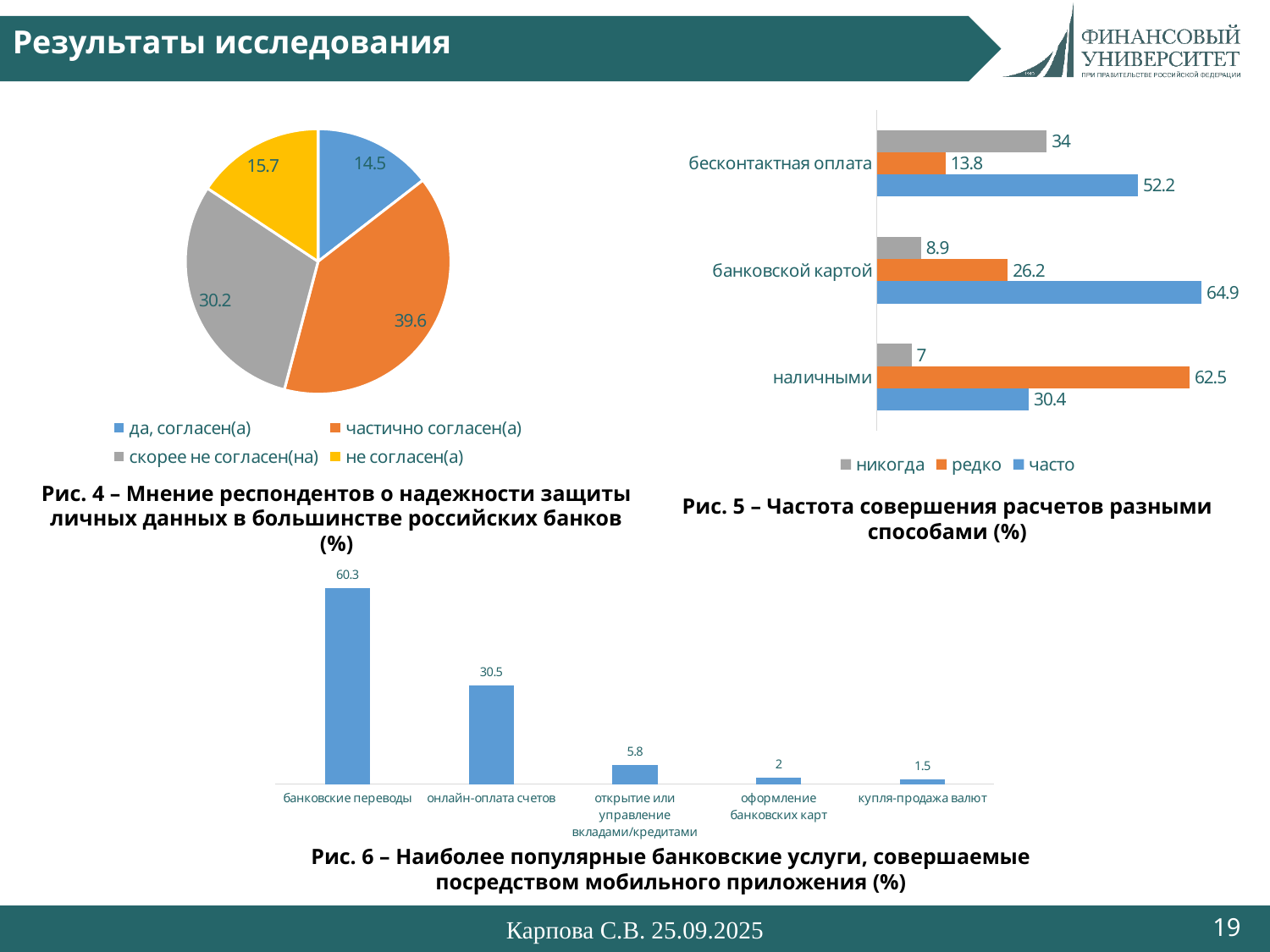
In the chart 'Рис. 6 – Наиболее популярные банковские услуги, совершаемые посредством мобильного приложения (%)', which category has the highest value? банковские переводы In the chart 'Рис. 4 – Мнение респондентов о надежности защиты личных данных в большинстве российских банков (%)', what is the value for 'частично согласен(а)'? 39.6 In the chart 'Рис. 4 – Мнение респондентов о надежности защиты личных данных в большинстве российских банков (%)', how many categories does the legend list? 4 In the chart 'Рис. 5 – Частота совершения расчетов разными способами (%)', what is the value of 'никогда' for 'наличными'? 7 In the chart 'Рис. 6 – Наиболее популярные банковские услуги, совершаемые посредством мобильного приложения (%)', what is the value for 'онлайн-оплата счетов'? 30.5 In the chart 'Рис. 5 – Частота совершения расчетов разными способами (%)', what is the value of 'часто' for 'банковской картой'? 64.9 In the chart 'Рис. 5 – Частота совершения расчетов разными способами (%)', how many series does the legend list? 3 In the chart 'Рис. 6 – Наиболее популярные банковские услуги, совершаемые посредством мобильного приложения (%)', do the values rise or fall from left to right along the x axis? fall What kind of chart is 'Рис. 4 – Мнение респондентов о надежности защиты личных данных в большинстве российских банков (%)'? pie chart In the chart 'Рис. 5 – Частота совершения расчетов разными способами (%)', which is larger for 'наличными': 'редко' or 'часто'? редко In the chart 'Рис. 4 – Мнение респондентов о надежности защиты личных данных в большинстве российских банков (%)', which category has the smallest slice? да, согласен(а) In the chart 'Рис. 5 – Частота совершения расчетов разными способами (%)', what is the difference between 'часто' and 'редко' for 'бесконтактная оплата'? 38.4